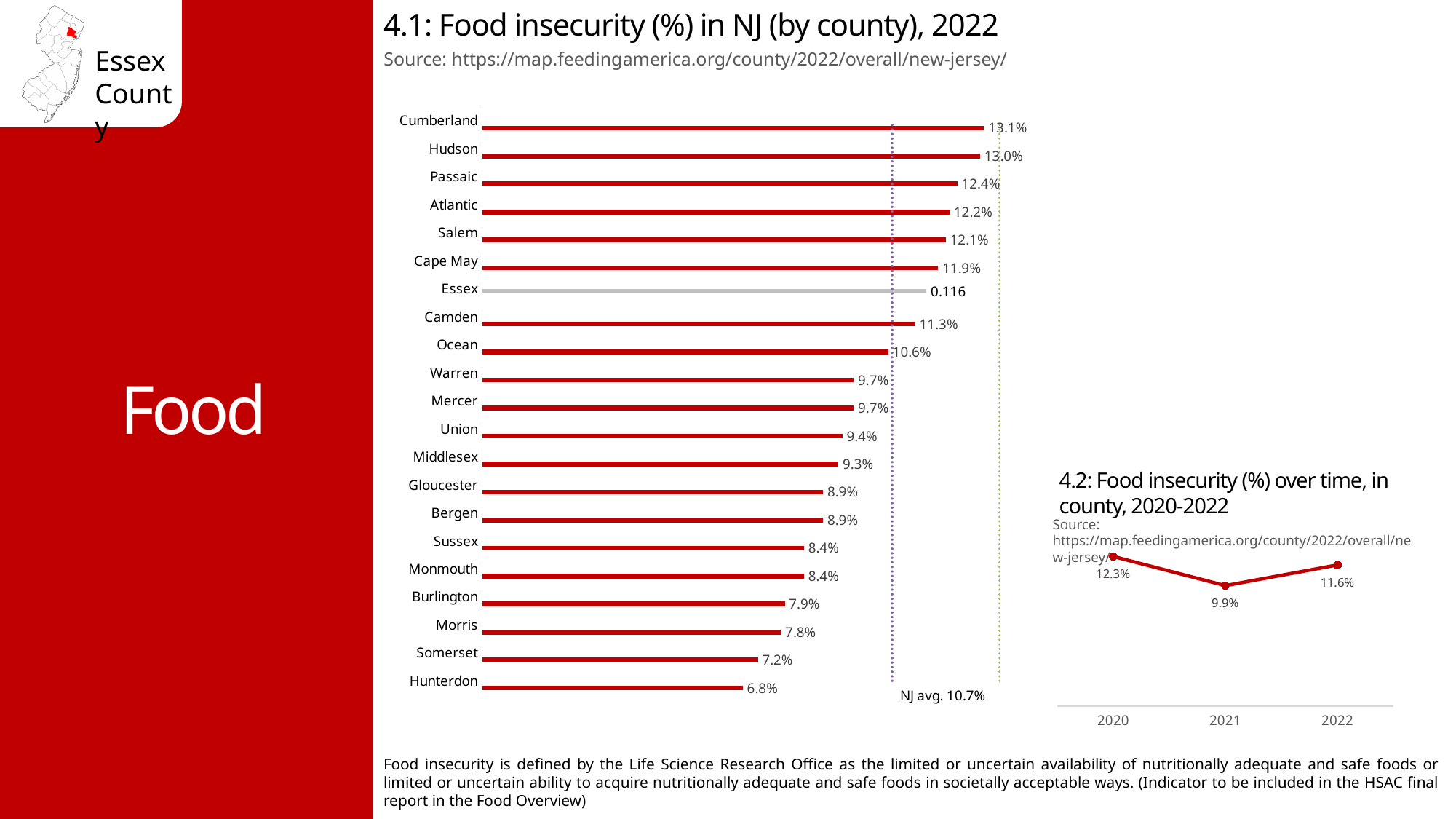
In chart 4.1 (Food insecurity in NJ by county, 2022), what NJ average value is labelled on the chart? 10.7% In chart 4.1 (Food insecurity in NJ by county, 2022), what is the data label shown for Essex? 0.116 In chart 4.1 (Food insecurity in NJ by county, 2022), what is the value for Hunterdon? 6.8% In chart 4.1 (Food insecurity in NJ by county, 2022), which is larger, Camden or Ocean? Camden In chart 4.1 (Food insecurity in NJ by county, 2022), what is the difference between Cumberland and Hunterdon? 6.3% In chart 4.1 (Food insecurity in NJ by county, 2022), what is the value for Cumberland? 13.1% In chart 4.1 (Food insecurity in NJ by county, 2022), how many counties are plotted? 21 In chart 4.1 (Food insecurity in NJ by county, 2022), which county has the lowest value? Hunterdon What kind of chart is chart 4.1 (Food insecurity in NJ by county, 2022)? Bar chart In chart 4.1 (Food insecurity in NJ by county, 2022), which county has the highest value? Cumberland In chart 4.2 (Food insecurity over time, 2020-2022), what is the difference between 2020 and 2022? 0.7% In chart 4.2 (Food insecurity over time, 2020-2022), what is the value for 2021? 9.9%